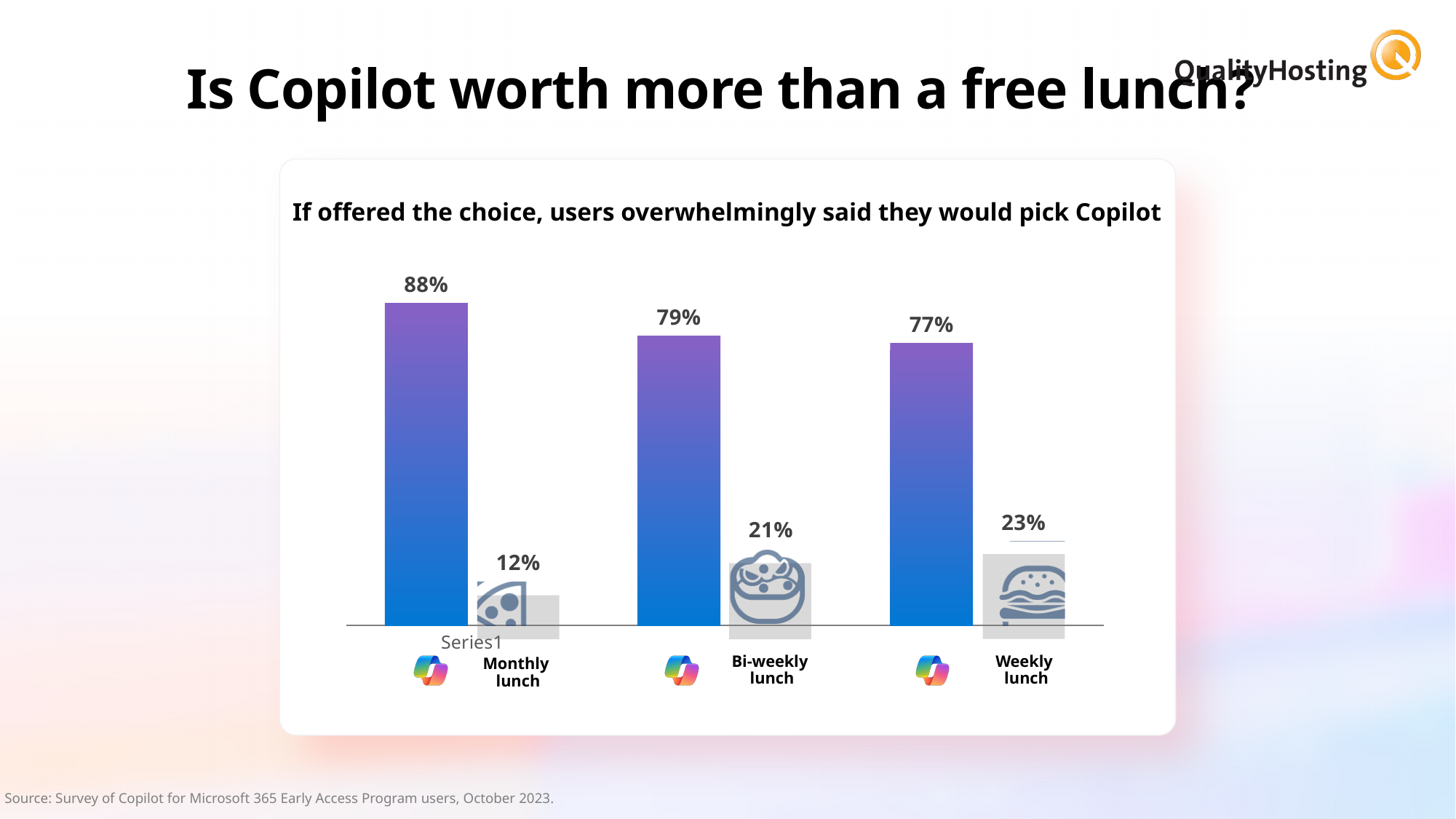
What is the difference between the Copilot share in the bi-weekly lunch comparison and the Copilot share in the weekly lunch comparison? 2 percentage points What is the subtitle shown above the chart? If offered the choice, users overwhelmingly said they would pick Copilot What is the difference between the share choosing Copilot and the share choosing the monthly lunch? 76 percentage points What percentage of users would pick Copilot over a monthly lunch? 88% What kind of chart is shown on the slide? Bar chart What percentage of users would pick the weekly lunch over Copilot? 23% Which is larger: the share choosing the weekly lunch or the share choosing the bi-weekly lunch? Weekly lunch What percentage of users would pick Copilot over a weekly lunch? 77% Which lunch option has the lowest share of users choosing it over Copilot? Monthly lunch In which lunch comparison is the share of users choosing Copilot highest? Monthly lunch How many lunch options are compared against Copilot in the chart? 3 What percentage of users would pick the bi-weekly lunch over Copilot? 21%